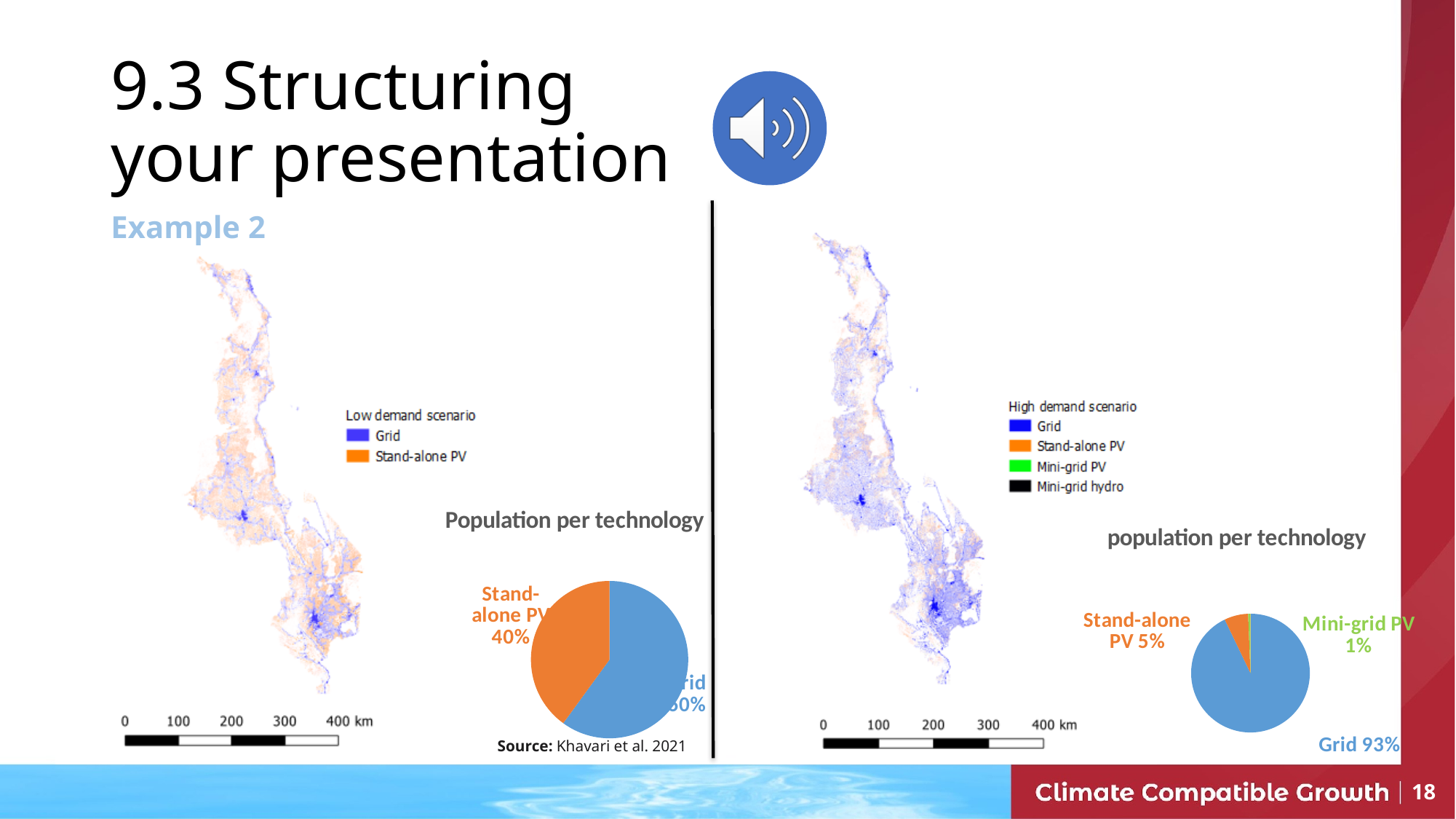
What type of chart is used on the right side of the slide to show population per technology? Pie chart On the left pie chart titled 'Population per technology', what is the difference in percentage points between the Grid share and the Stand-alone PV share? 20 percentage points On the right pie chart titled 'population per technology', which labelled technology has the smallest share? Mini-grid PV On the left pie chart titled 'Population per technology', which technology has the larger share? Grid On the right pie chart titled 'population per technology', what share of the population is served by Mini-grid PV? 1% On the left pie chart titled 'Population per technology', how many slices does the pie have? 2 On the right pie chart titled 'population per technology', what colour is the Grid slice? Blue On the left pie chart titled 'Population per technology', what share of the population is served by Stand-alone PV? 40% On the right pie chart titled 'population per technology', what share of the population is served by Stand-alone PV? 5% On the right pie chart titled 'population per technology', which is larger: the Stand-alone PV share or the Mini-grid PV share? Stand-alone PV On the left pie chart titled 'Population per technology', what share of the population is served by Grid? 60% On the right pie chart titled 'population per technology', what share of the population is served by Grid? 93%